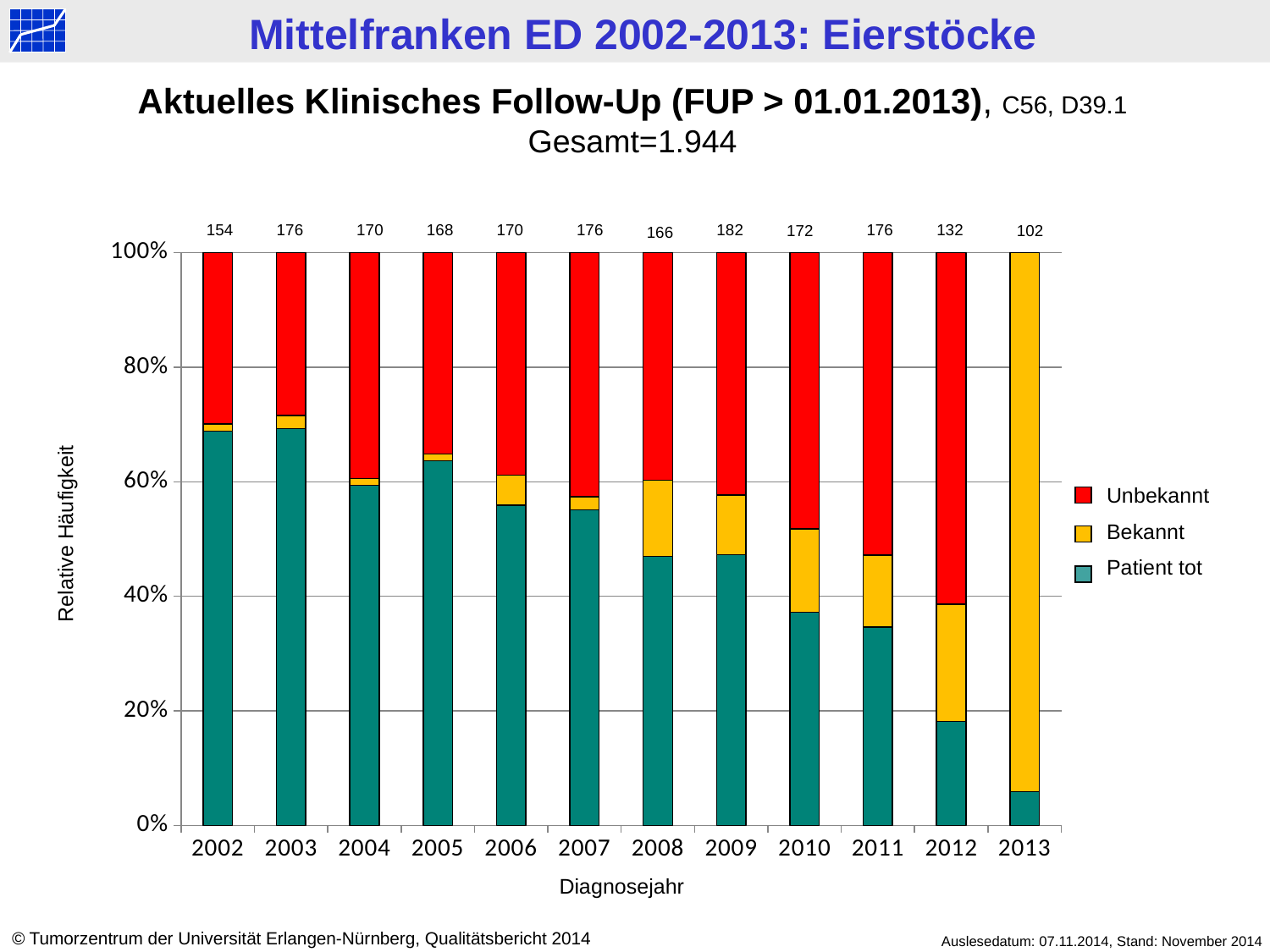
What is the difference between the numbers printed above the bars for 2009 and 2013? 80 How many series does the legend list? 3 What kind of chart is shown on the slide? Stacked bar chart What number is printed above the bar for 2002? 154 Which diagnosis year has the lowest number printed above its bar? 2013 How many diagnosis years are shown on the x axis? 12 Which year has the larger number printed above its bar, 2002 or 2003? 2003 Is the 'Patient tot' share for 2002 greater or less than 60%? greater Which diagnosis year has the highest number printed above its bar? 2009 Is the 'Patient tot' share for 2012 greater or less than 20%? less What number is printed above the bar for 2009? 182 What number is printed above the bar for 2013? 102